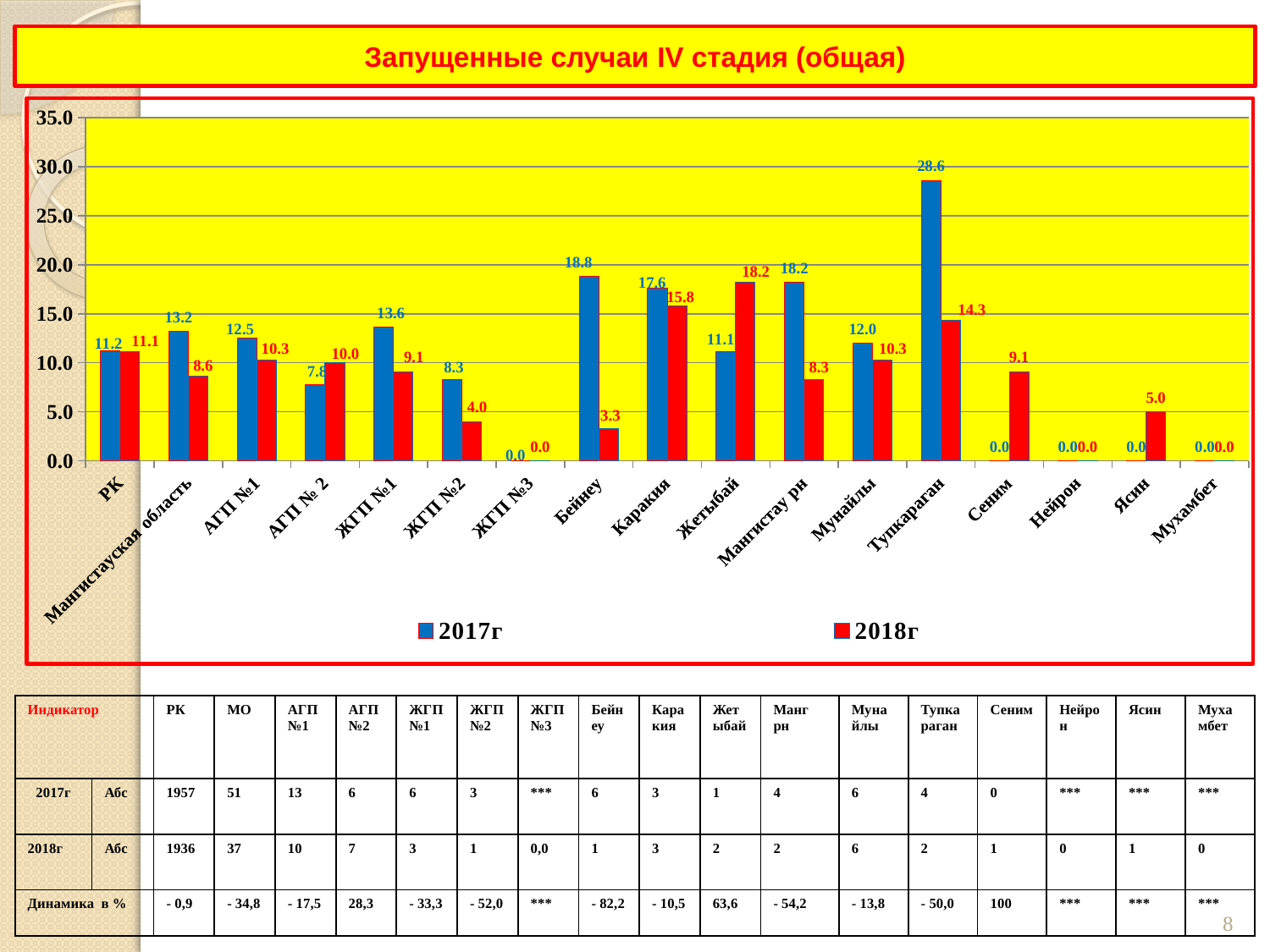
What is the 2018г value for Жетыбай? 18.2 How many categories are shown on the x axis? 17 What is the 2018г value for Бейнеу? 3.3 What is the 2017г value for Тупкараган? 28.6 Is the 2017г value for Каракия greater or less than 15.0? greater What is the difference between the 2017г and 2018г values for Тупкараган? 14.3 Which category has the highest 2017г value? Тупкараган What is the difference between the 2017г and 2018г values for Бейнеу? 15.5 How many series does the legend list? 2 Which category has the highest 2018г value? Жетыбай What kind of chart is shown on the slide? bar chart Which is larger for Жетыбай, the 2017г value or the 2018г value? 2018г